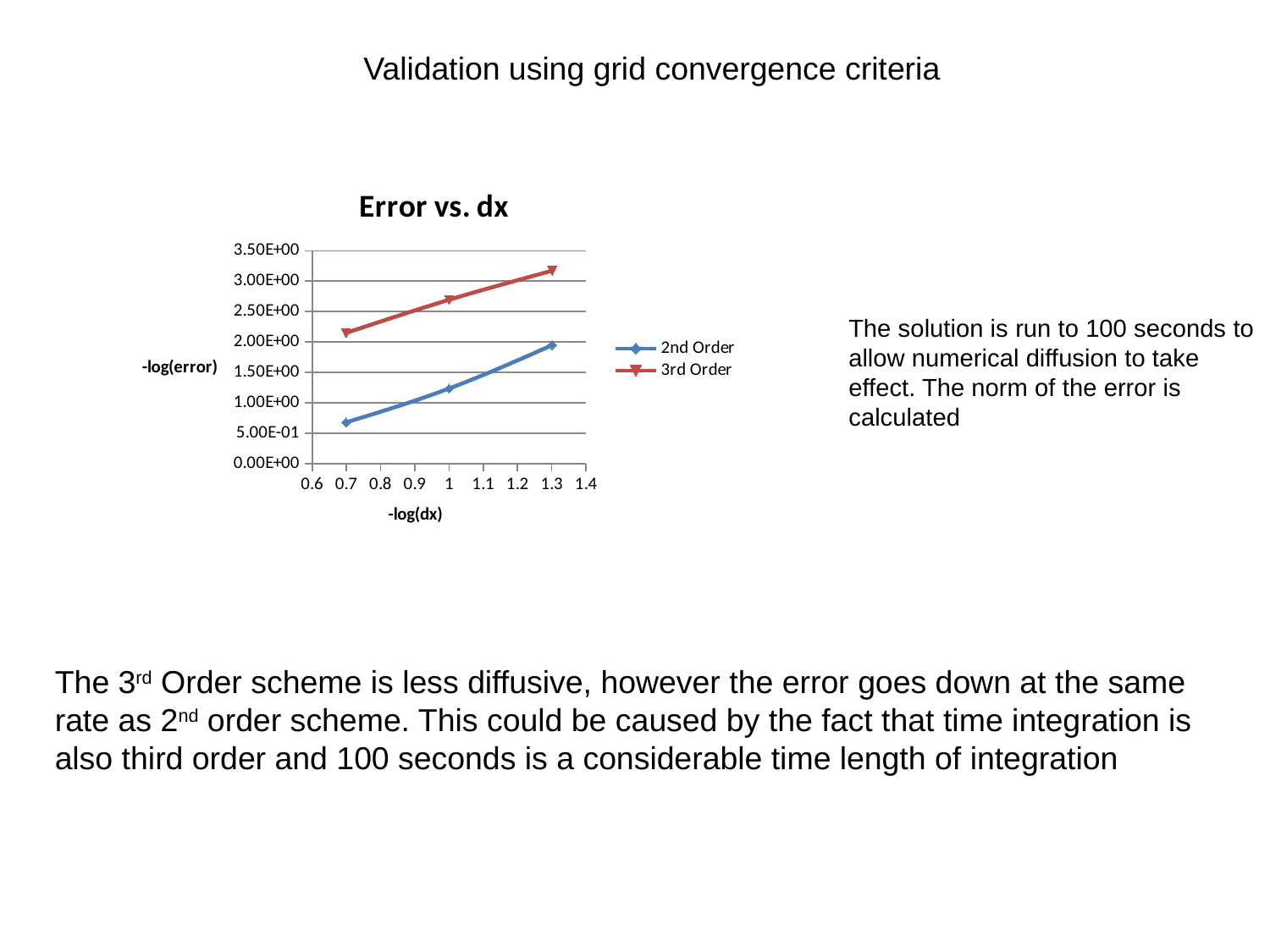
Is the 3rd Order value at -log(dx) = 1 greater or less than 2.50E+00? greater What is the title of the chart? Error vs. dx Do the values of the 2nd Order series rise or fall along the x axis? rise What is the label of the x axis of the chart? -log(dx) What kind of chart is shown on the slide? line chart How many series does the legend of the "Error vs. dx" chart list? 2 How many data points are plotted for the 2nd Order series? 3 At -log(dx) = 1, which series has the larger -log(error) value, 2nd Order or 3rd Order? 3rd Order Is the 2nd Order value at -log(dx) = 0.7 greater or less than 1.00E+00? less Is the 3rd Order value at -log(dx) = 1.3 greater or less than 3.00E+00? greater Do the values of the 3rd Order series rise or fall as -log(dx) increases? rise